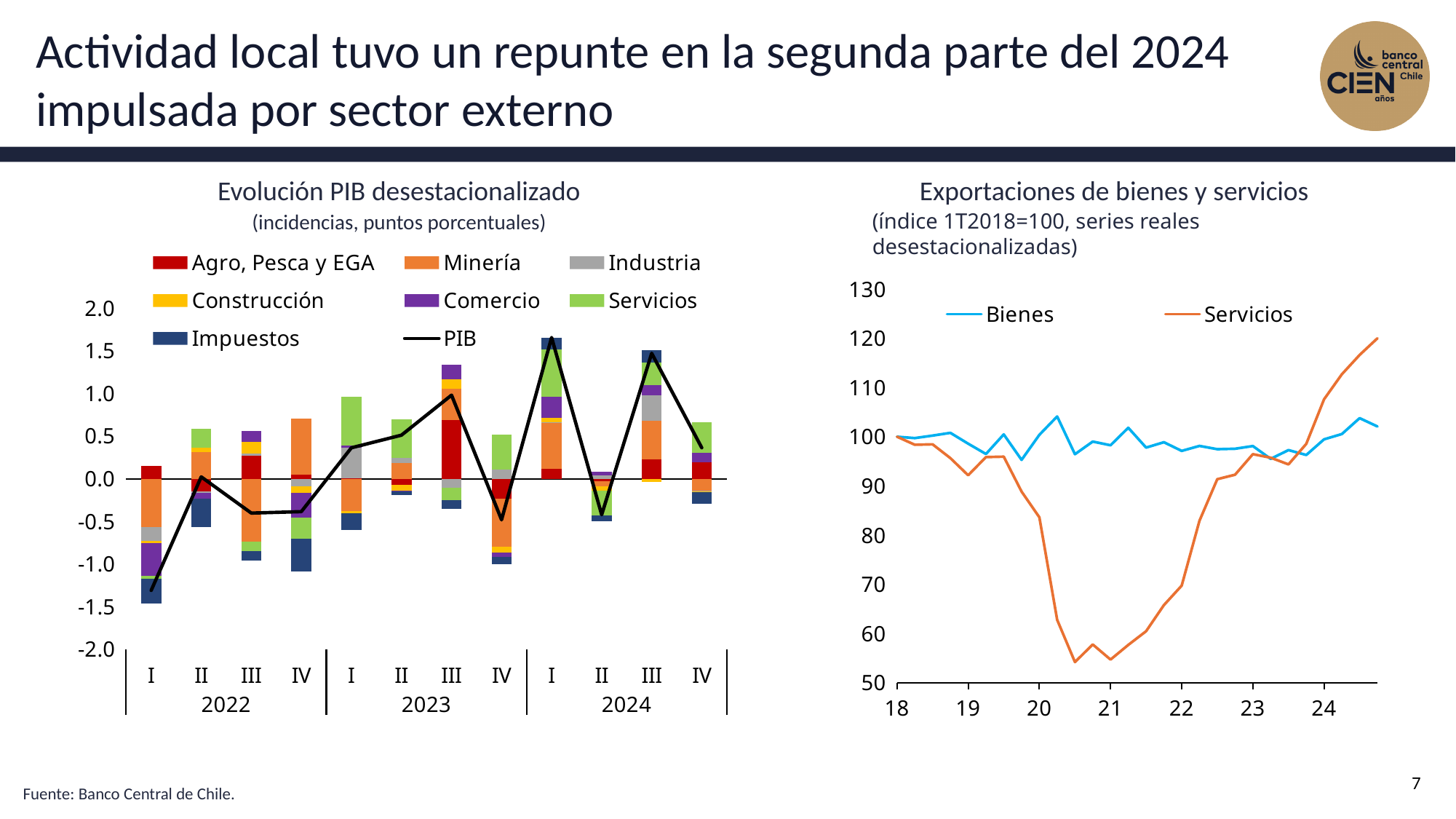
In the 'Evolución PIB desestacionalizado' chart, in which quarter is the PIB line at its lowest? 2022 I In the 'Evolución PIB desestacionalizado' chart, is the PIB value for 2022 I greater or less than -1.0? less In the 'Exportaciones de bienes y servicios' chart, which series is higher at the end of 2024, Bienes or Servicios? Servicios In the 'Evolución PIB desestacionalizado' chart, how many quarters are shown on the x axis? 12 What kind of chart is the 'Evolución PIB desestacionalizado' chart on the left? combination bar and line chart In the 'Exportaciones de bienes y servicios' chart, is the lowest value of the Servicios series greater or less than 60? less In the 'Evolución PIB desestacionalizado' chart, is the PIB value for 2024 I greater or less than 1.5? greater In the 'Exportaciones de bienes y servicios' chart, does the Servicios series rise or fall from 2022 to the end of 2024? rise In the 'Evolución PIB desestacionalizado' chart, how many entries does the legend list? 8 What kind of chart is the 'Exportaciones de bienes y servicios' chart on the right? line chart In the 'Exportaciones de bienes y servicios' chart, how many series does the legend list? 2